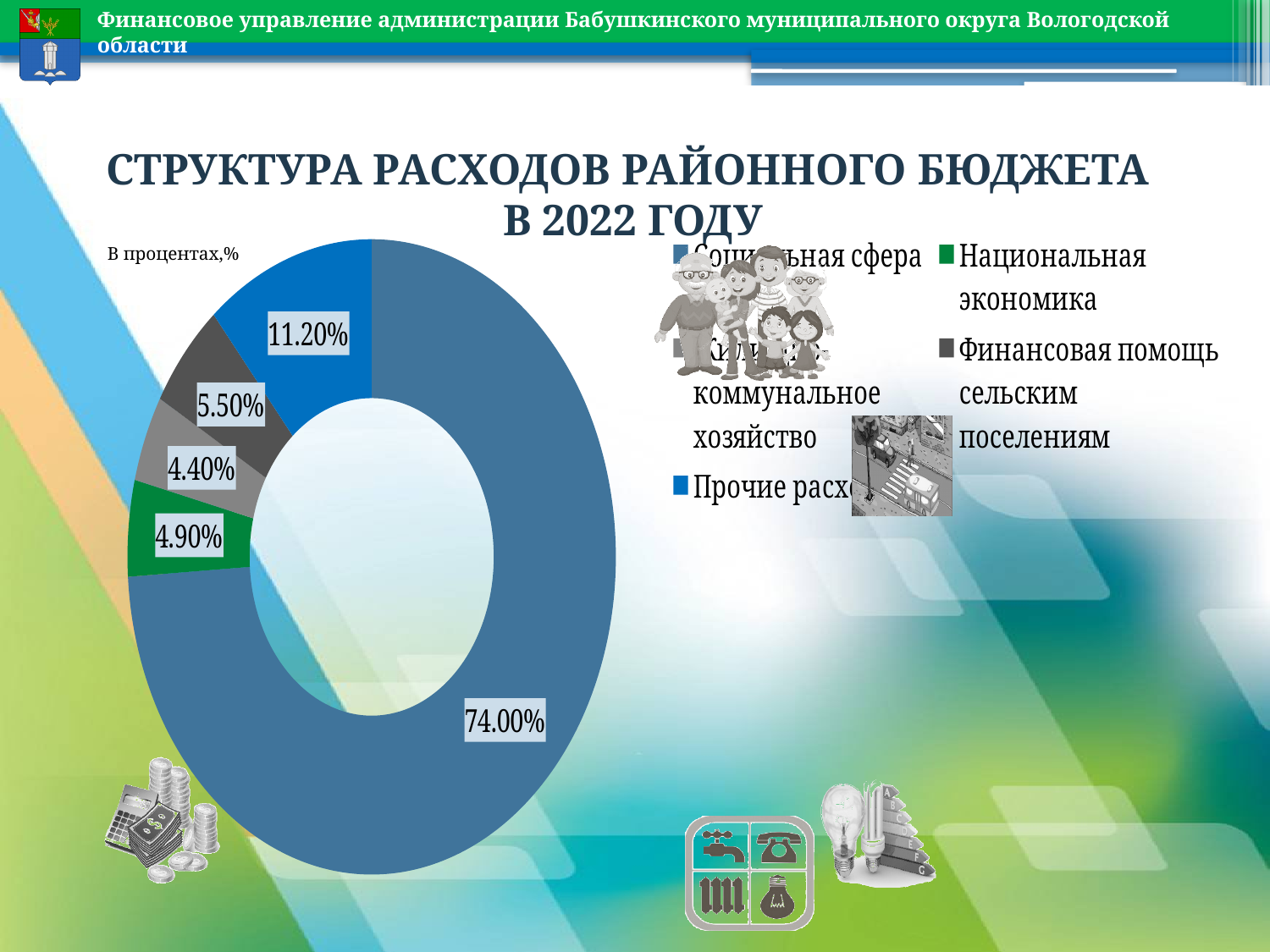
What unit is indicated in the note at the top left of the chart? В процентах,% What is the largest value shown on the chart? 74.00% What is the title of the chart on the slide? СТРУКТУРА РАСХОДОВ РАЙОННОГО БЮДЖЕТА В 2022 ГОДУ How many entries does the chart legend list? 5 What is the difference between the 11.20% slice and the 5.50% slice? 5.70% What is the smallest value shown on the chart? 4.40% What share of expenditures is shown for Социальная сфера? 74.00% What kind of chart is shown on the slide? Pie chart (doughnut) What share is shown for Финансовая помощь сельским поселениям? 5.50% Which is larger: the slice for Национальная экономика or the slice for Финансовая помощь сельским поселениям? Финансовая помощь сельским поселениям What share is shown for Национальная экономика? 4.90% How many slices does the doughnut chart have? 5